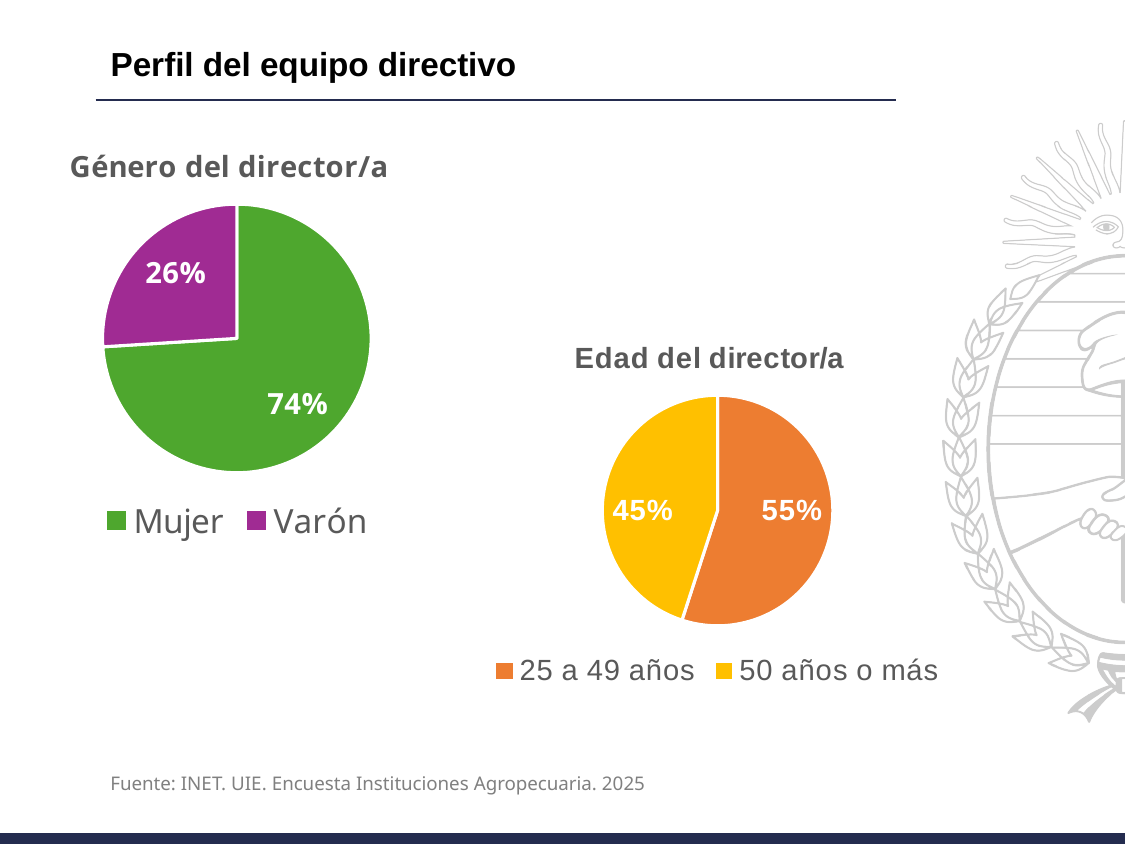
In the 'Género del director/a' chart, what colour is the Varón slice? Purple In the 'Edad del director/a' chart, which category has the smallest share? 50 años o más In the 'Género del director/a' chart, what is the difference in percentage points between Mujer and Varón? 48 In the 'Género del director/a' chart, which category has the largest share? Mujer In the 'Edad del director/a' chart, which is larger: '25 a 49 años' or '50 años o más'? 25 a 49 años How many categories does the 'Edad del director/a' chart show? 2 In the 'Género del director/a' chart, what percentage is Varón? 26% In the 'Edad del director/a' chart, what is the difference in percentage points between '25 a 49 años' and '50 años o más'? 10 In the 'Edad del director/a' chart, what percentage is '25 a 49 años'? 55% What kind of chart is the 'Género del director/a' chart? Pie chart In the 'Edad del director/a' chart, what percentage is '50 años o más'? 45% In the 'Género del director/a' chart, what percentage is Mujer? 74%